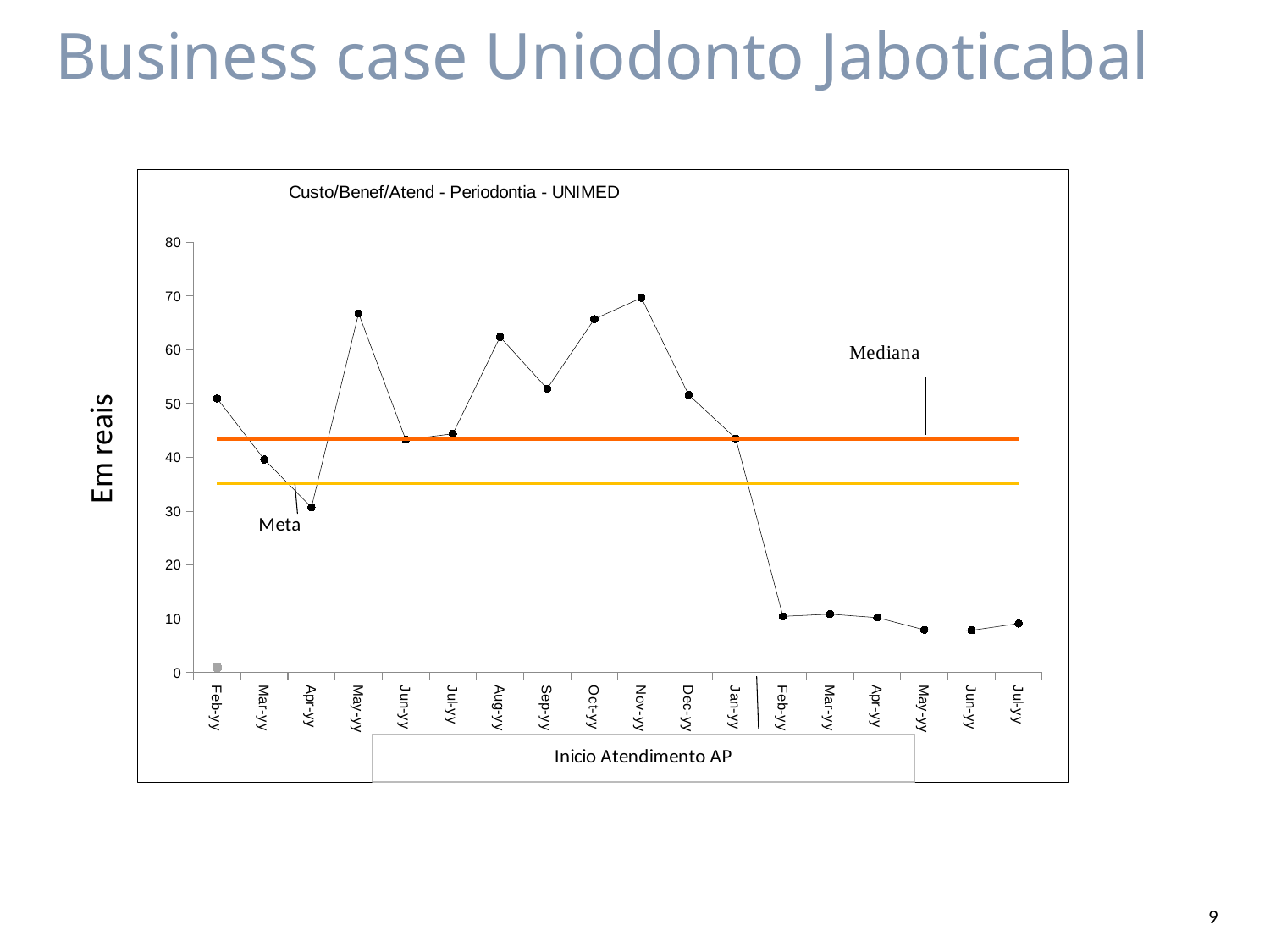
Does the plotted line rise or fall between Jan-yy and the following Feb-yy? fall Is the value for Dec-yy greater or less than 40? greater Which is larger, the value for Aug-yy or the value for Dec-yy? Aug-yy What kind of chart is shown on the slide? line chart Is the value for Sep-yy greater or less than 60? less Which month has the highest plotted value in the chart? Nov-yy What is the title of the chart? Custo/Benef/Atend - Periodontia - UNIMED How many monthly points are plotted along the x axis of the chart? 18 Is the value for Nov-yy greater or less than 60? greater What is the label on the vertical axis of the chart? Em reais Which is larger, the value for Sep-yy or the value for Nov-yy? Nov-yy